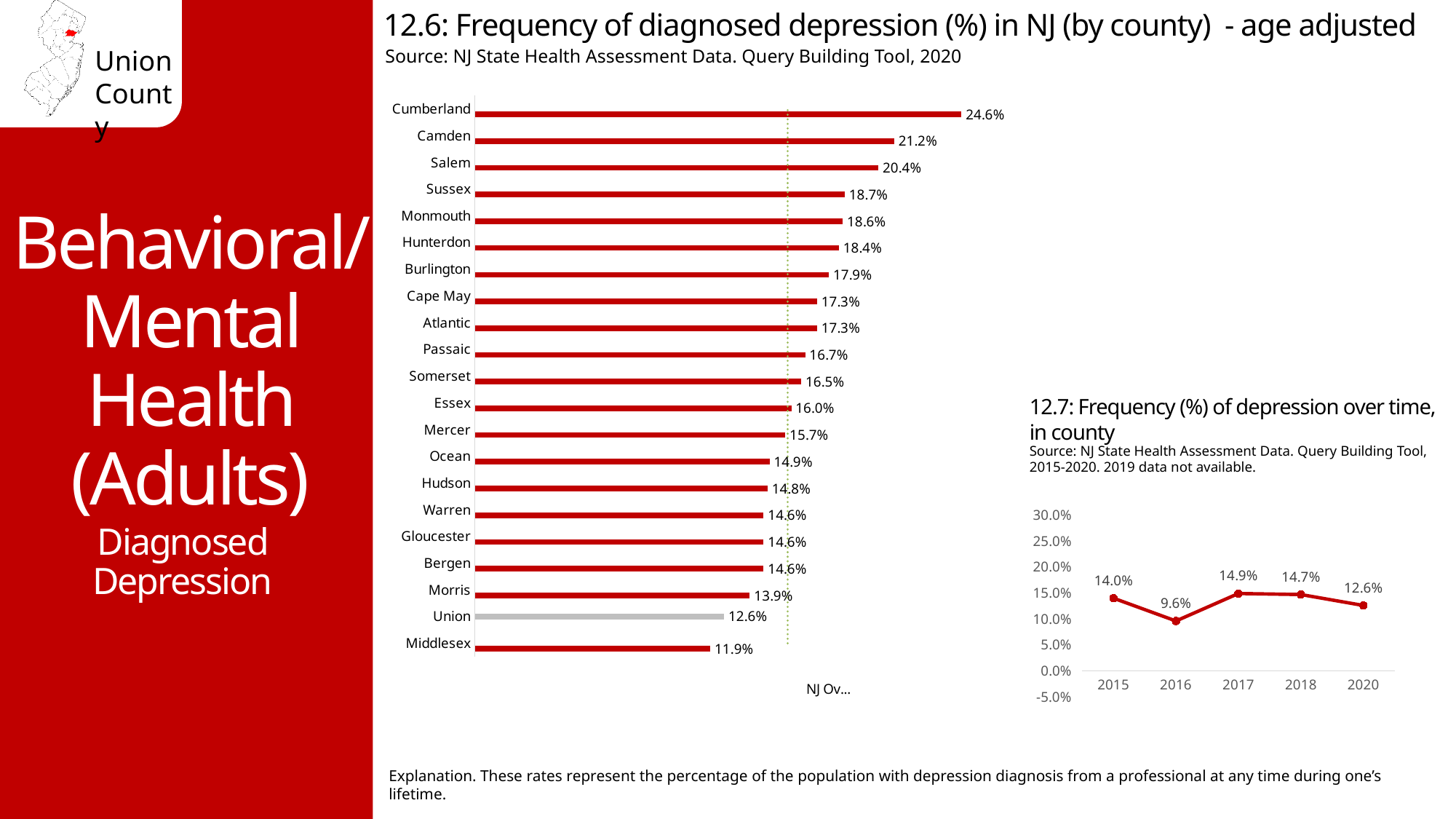
In chart 12.6 (frequency of diagnosed depression by county), what is the difference between Camden and Salem? 0.8% In chart 12.6 (frequency of diagnosed depression by county), how many counties are plotted? 21 In chart 12.6 (frequency of diagnosed depression by county), what is the value for Cumberland? 24.6% What kind of chart is chart 12.6 (frequency of diagnosed depression by county)? Bar chart In chart 12.7 (frequency of depression over time in county), what is the value for 2016? 9.6% In chart 12.6 (frequency of diagnosed depression by county), which county has the highest value? Cumberland In chart 12.6 (frequency of diagnosed depression by county), what is the value for Union? 12.6% In chart 12.6 (frequency of diagnosed depression by county), which is larger, the value for Hunterdon or the value for Burlington? Hunterdon In chart 12.7 (frequency of depression over time in county), which year has the highest value? 2017 In chart 12.7 (frequency of depression over time in county), what is the difference between the 2015 and 2020 values? 1.4% What kind of chart is chart 12.7 (frequency of depression over time in county)? Line chart In chart 12.6 (frequency of diagnosed depression by county), which county has the lowest value? Middlesex